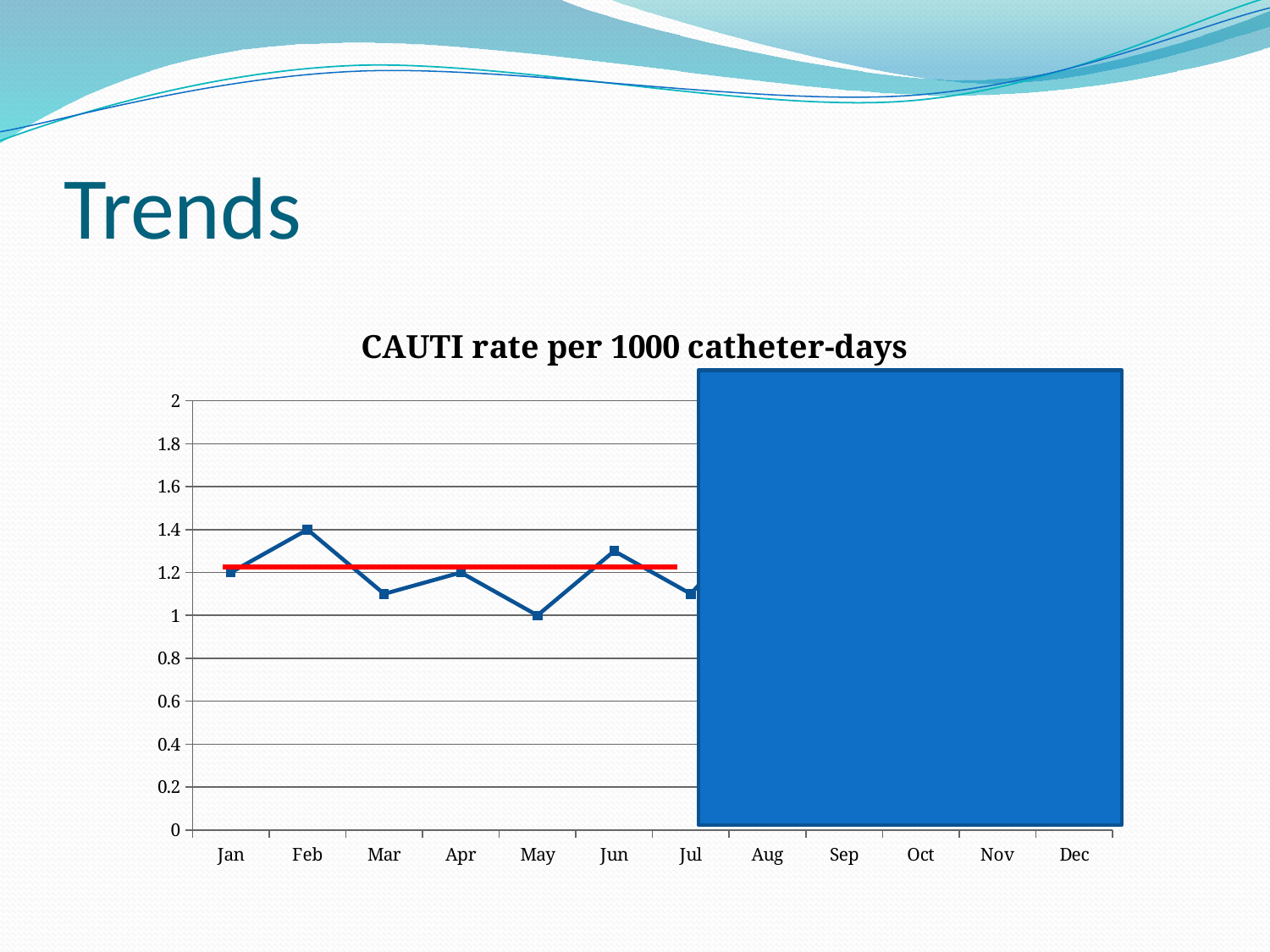
Which month has the lowest plotted CAUTI rate? May What is the CAUTI rate for May? 1 What kind of chart is shown on the slide? line chart What is the CAUTI rate for Jan? 1.2 What is the CAUTI rate for Feb? 1.4 How many months are labeled on the x axis? 12 What is the title of the chart? CAUTI rate per 1000 catheter-days Is the CAUTI rate for Mar greater or less than 1.2? less Which month has the highest plotted CAUTI rate? Feb Which month has a higher CAUTI rate, Feb or Jun? Feb Is the CAUTI rate for Jun greater or less than 1.2? greater What is the difference between the CAUTI rate in Feb and in May? 0.4